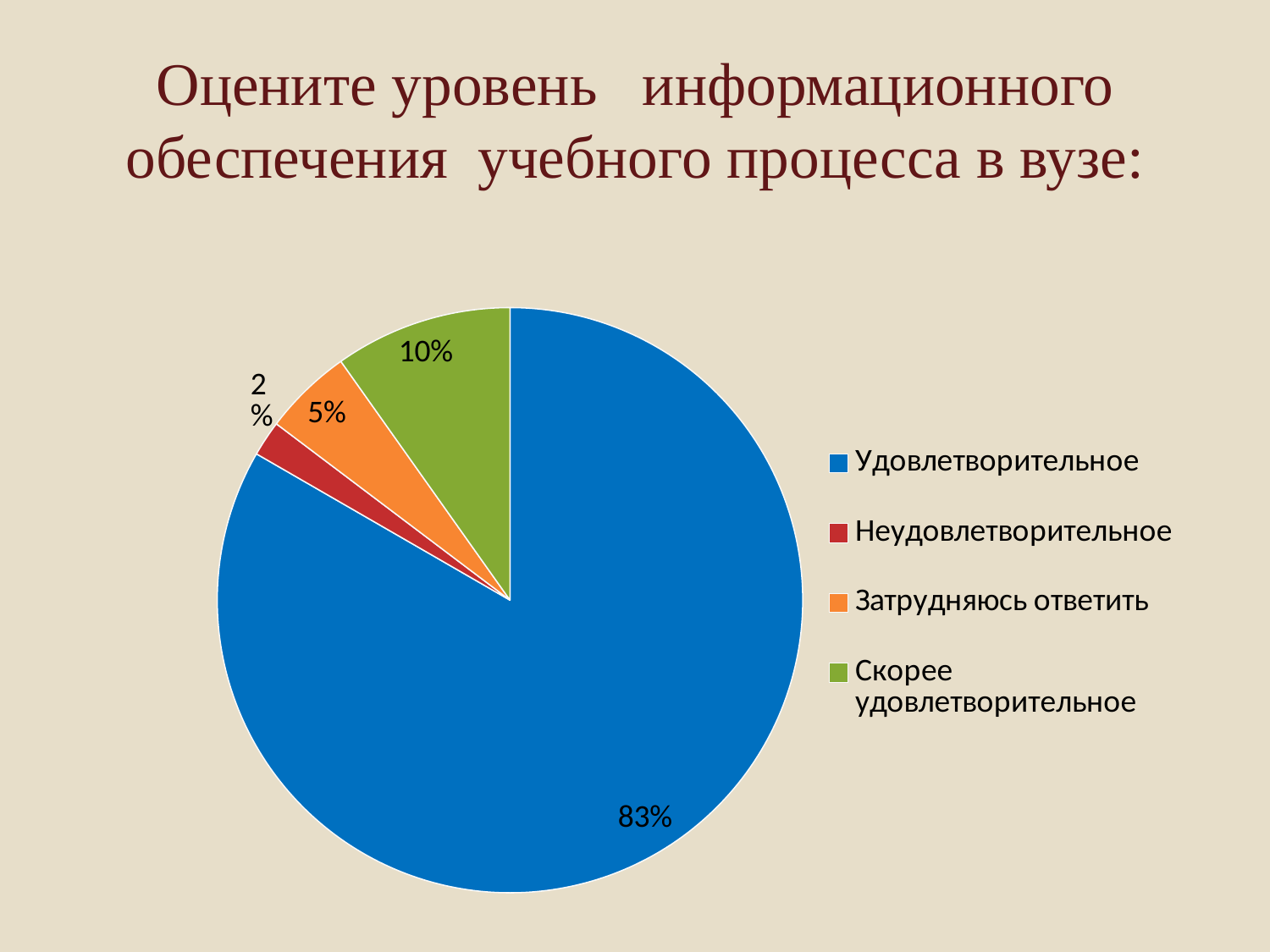
What share of the pie is labelled "Неудовлетворительное"? 2% Which category has the smallest slice of the pie? Неудовлетворительное What share of the pie is labelled "Скорее удовлетворительное"? 10% What colour is the slice for "Затрудняюсь ответить"? orange What share of the pie is labelled "Удовлетворительное"? 83% What share of the pie is labelled "Затрудняюсь ответить"? 5% What kind of chart is shown on the slide? pie chart Which is larger: the share for "Затрудняюсь ответить" or the share for "Скорее удовлетворительное"? Скорее удовлетворительное What is the difference between the shares for "Удовлетворительное" and "Скорее удовлетворительное"? 73% How many entries does the legend list? 4 Which category has the largest slice of the pie? Удовлетворительное How many slices does the pie chart have? 4